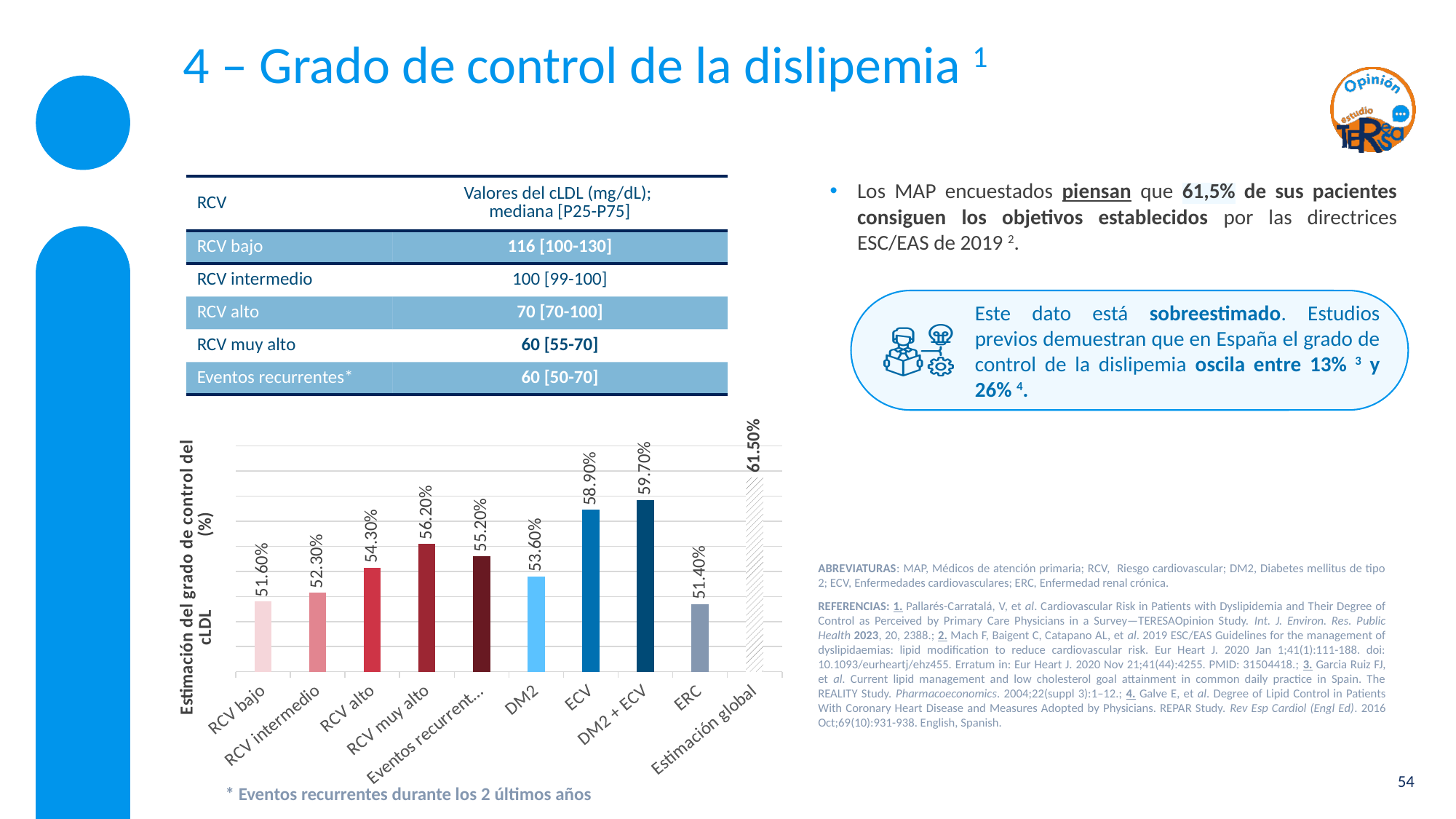
What kind of chart is shown on the slide? Bar chart Which is larger in the bar chart, the value for RCV alto or the value for DM2? RCV alto What is the difference between the values for ECV and DM2 in the bar chart? 5.30% What is the value for DM2 + ECV in the bar chart? 59.70% What is the label of the vertical axis of the bar chart? Estimación del grado de control del cLDL (%) What is the value for ERC in the bar chart? 51.40% Which category has the highest value in the bar chart? Estimación global What is the value for RCV bajo in the bar chart? 51.60% What is the value for Estimación global in the bar chart? 61.50% How many categories are shown in the bar chart? 10 Which category has the lowest value in the bar chart? ERC What is the difference between the values for RCV muy alto and RCV bajo in the bar chart? 4.60%